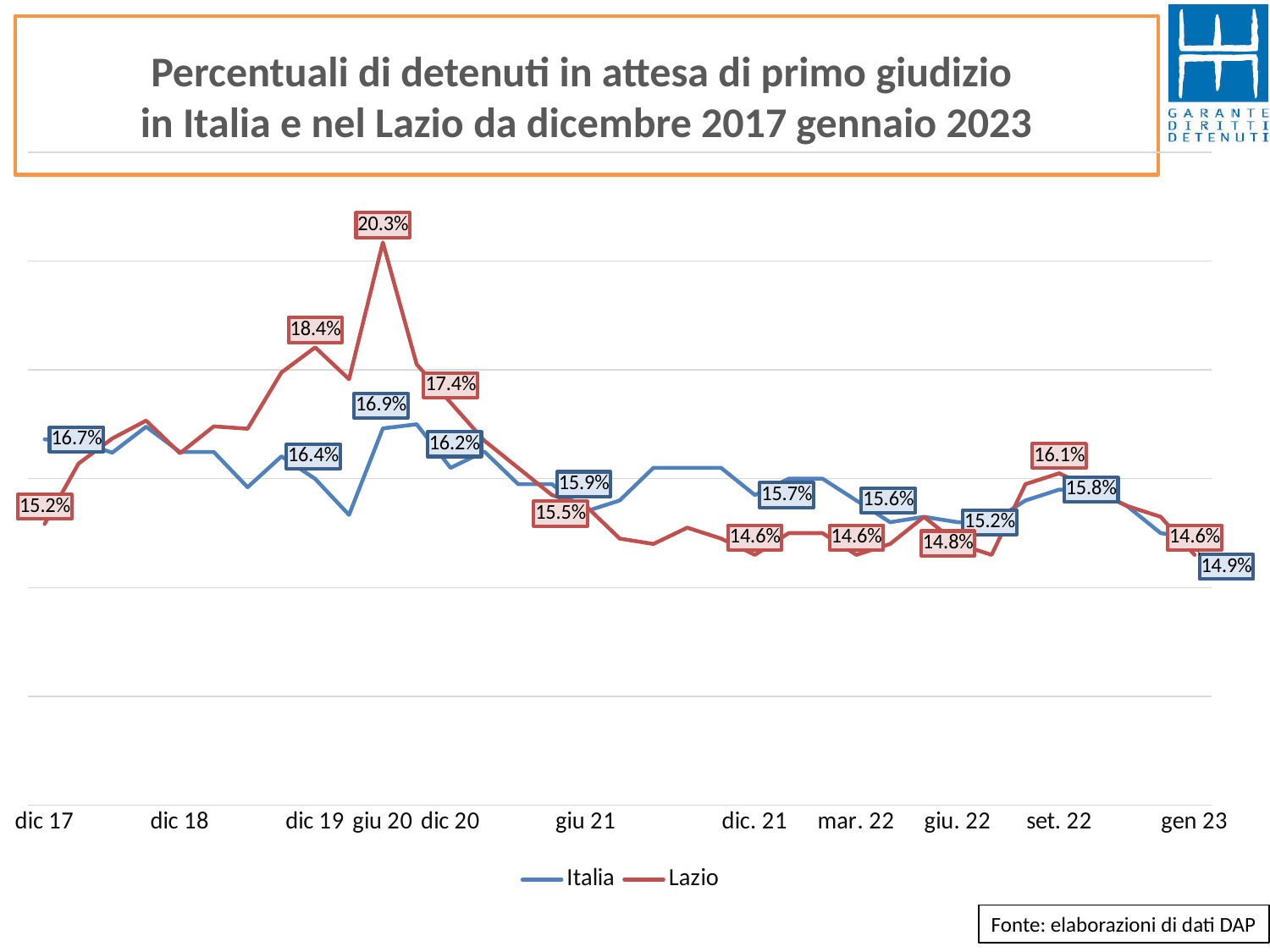
At dic 20, which series has the higher value, Italia or Lazio? Lazio What is the value for Italia at dic 17? 16.7% Which colour is used for the Lazio series? red What is the value for Lazio at dic 19? 18.4% How many series does the legend list? 2 Does the Italia series rise or fall overall from dic 17 to gen 23? fall What is the difference between the Lazio and Italia values at giu 20? 3.4 percentage points What is the value for Italia at gen 23? 14.9% What kind of chart is shown on the slide? line chart What is the value for Lazio at giu 20? 20.3% At which point does the Lazio series reach its highest value? giu 20